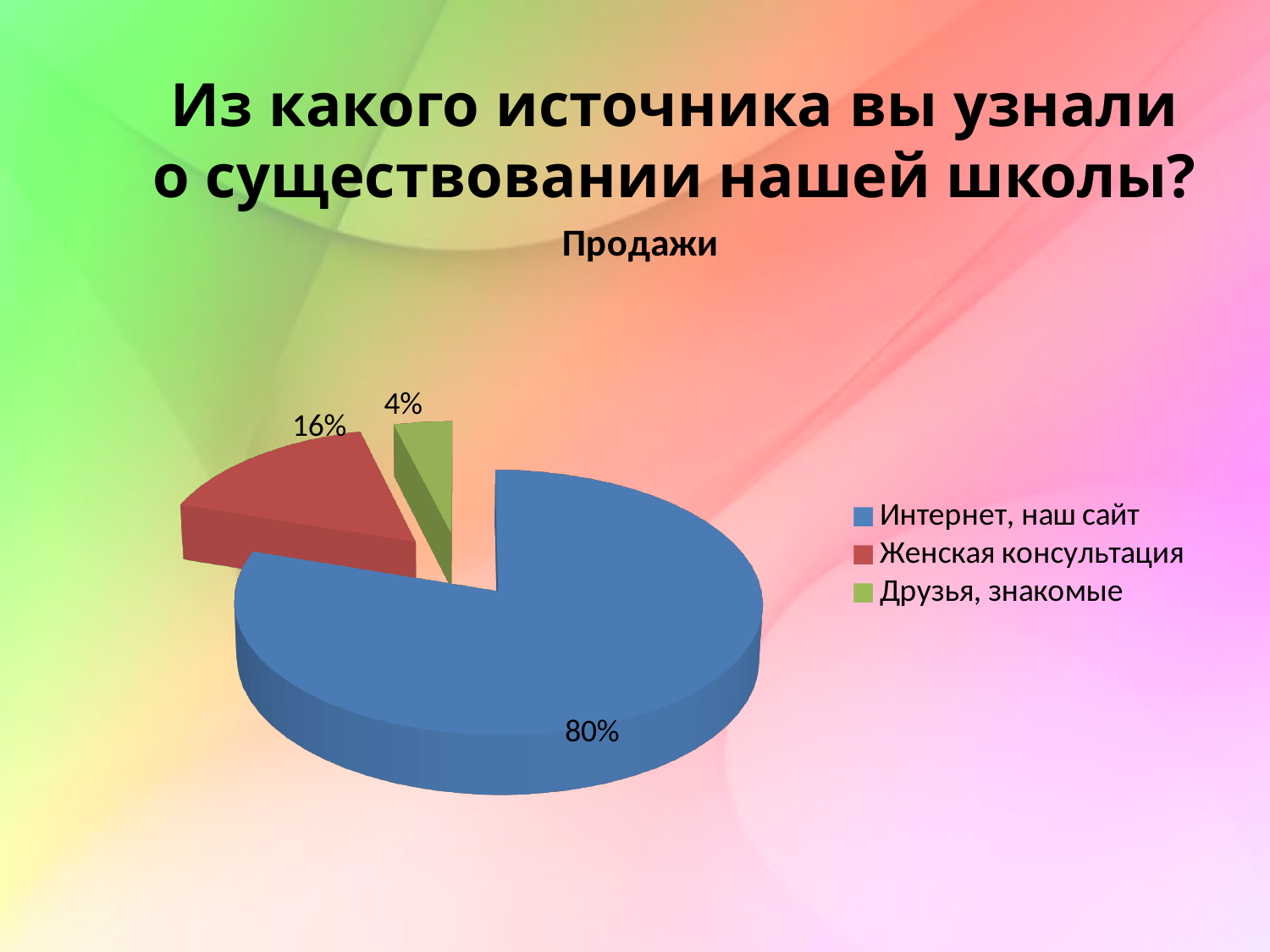
Which category has the largest slice of the pie? Интернет, наш сайт Which is larger: the slice for "Женская консультация" or the slice for "Друзья, знакомые"? Женская консультация Which category has the smallest slice of the pie? Друзья, знакомые What is the difference in percentage points between "Интернет, наш сайт" and "Женская консультация"? 64 Which colour represents "Интернет, наш сайт" in the legend? Blue What share of the pie does "Женская консультация" account for? 16% What share of the pie does "Интернет, наш сайт" account for? 80% What kind of chart is shown on the slide? Pie chart What is the difference in percentage points between "Женская консультация" and "Друзья, знакомые"? 12 How many categories does the pie chart show? 3 What is the title of the chart? Продажи What share of the pie does "Друзья, знакомые" account for? 4%